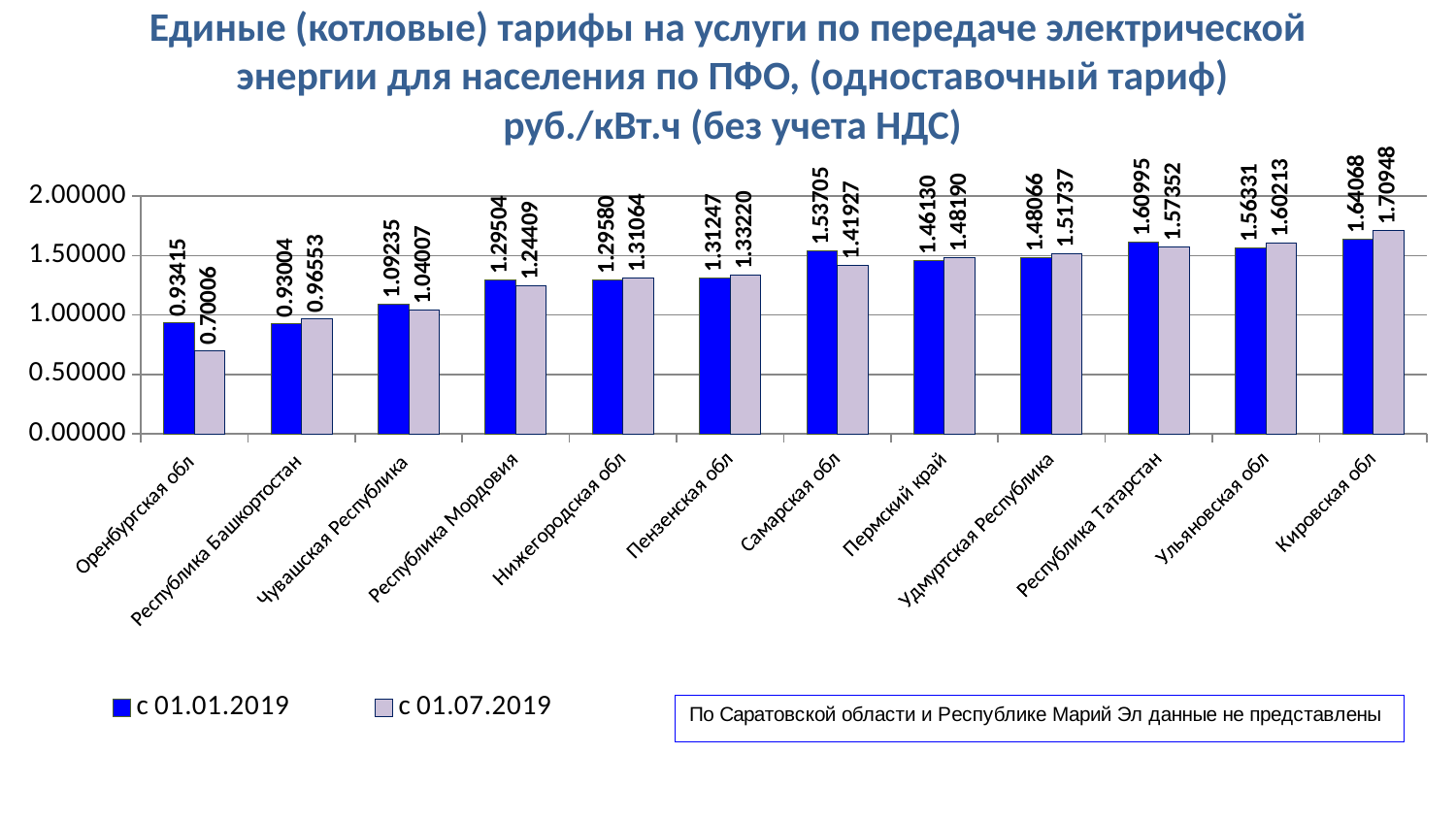
What is the difference between the с 01.07.2019 and с 01.01.2019 values for Кировская обл? 0.06880 Which region has the highest value in the с 01.01.2019 series? Кировская обл For Самарская обл, which is larger: the с 01.01.2019 value or the с 01.07.2019 value? с 01.01.2019 Which region has the lowest value in the с 01.07.2019 series? Оренбургская обл What is the value for Республика Мордовия in the с 01.07.2019 series? 1.24409 What is the value for Самарская обл in the с 01.01.2019 series? 1.53705 What is the value for Кировская обл in the с 01.07.2019 series? 1.70948 How many series does the legend list? 2 Is the с 01.01.2019 value for Чувашская Республика greater or less than 1.00000? greater Which region has the highest value in the с 01.07.2019 series? Кировская обл How many regions are shown on the x axis? 12 What kind of chart is shown on the slide? bar chart